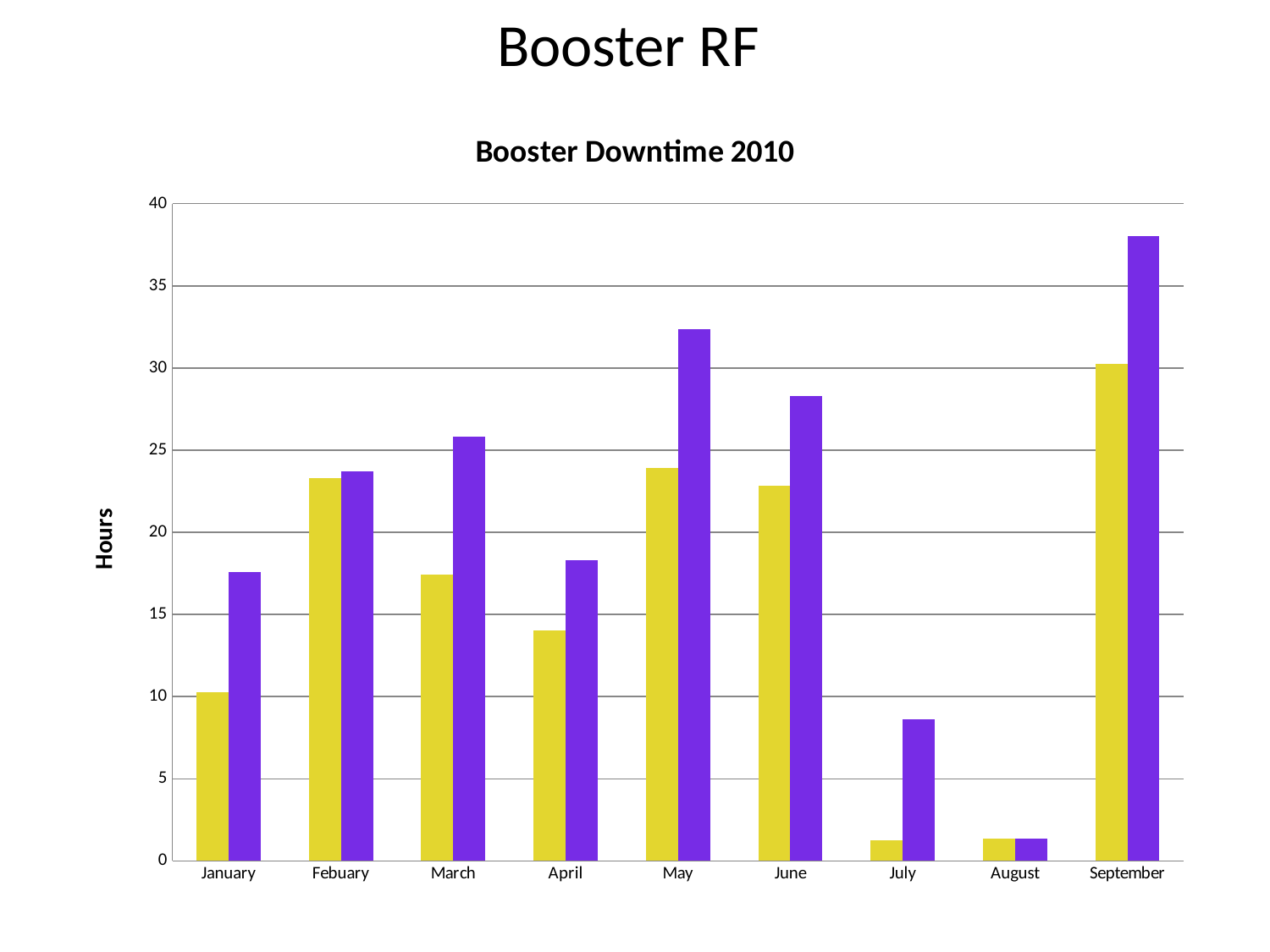
Is the yellow bar for January greater or less than 15? less What is the title of the chart? Booster Downtime 2010 Is the purple bar for September greater or less than 35? greater Which is larger in March, the yellow bar or the purple bar? the purple bar Is the purple bar for May greater or less than 30? greater Which month has the tallest purple bar? September Which month has the tallest yellow bar? September Which month has the shortest purple bar? August How many months are shown on the x axis of the chart? 9 What type of chart is shown on the slide? bar chart What is the label of the vertical axis? Hours